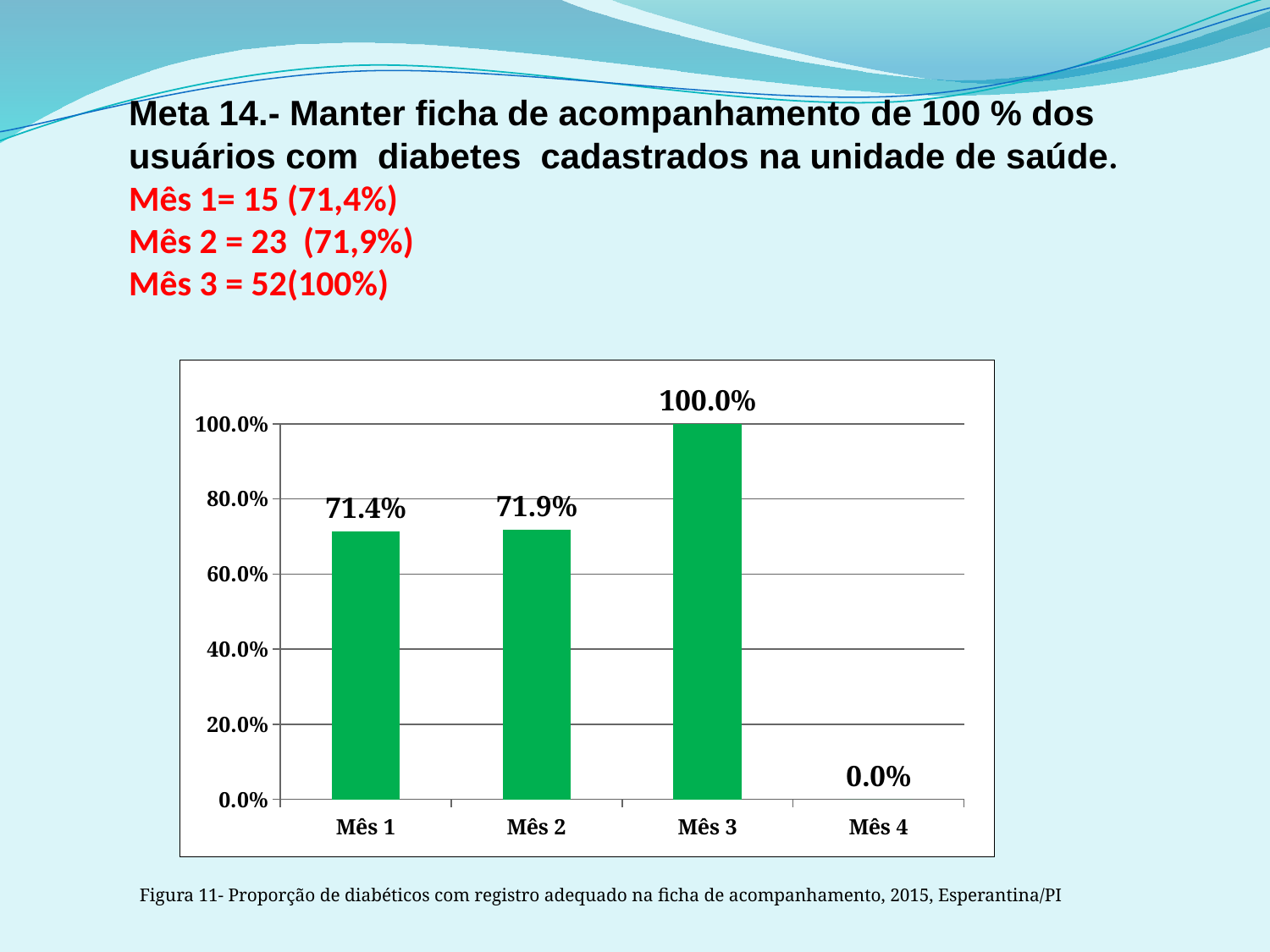
What is the difference between the values for Mês 2 and Mês 1? 0.5% What is the value for Mês 2? 71.9% Which is larger, the value for Mês 3 or the value for Mês 2? Mês 3 What is the value for Mês 4? 0.0% Is the value for Mês 1 greater or less than 80.0%? less Which category has the highest value? Mês 3 What kind of chart is shown on the slide? bar chart What is the value for Mês 1? 71.4% What is the difference between the values for Mês 3 and Mês 1? 28.6% Which category has the lowest value? Mês 4 What is the value for Mês 3? 100.0% How many categories are shown on the x axis? 4